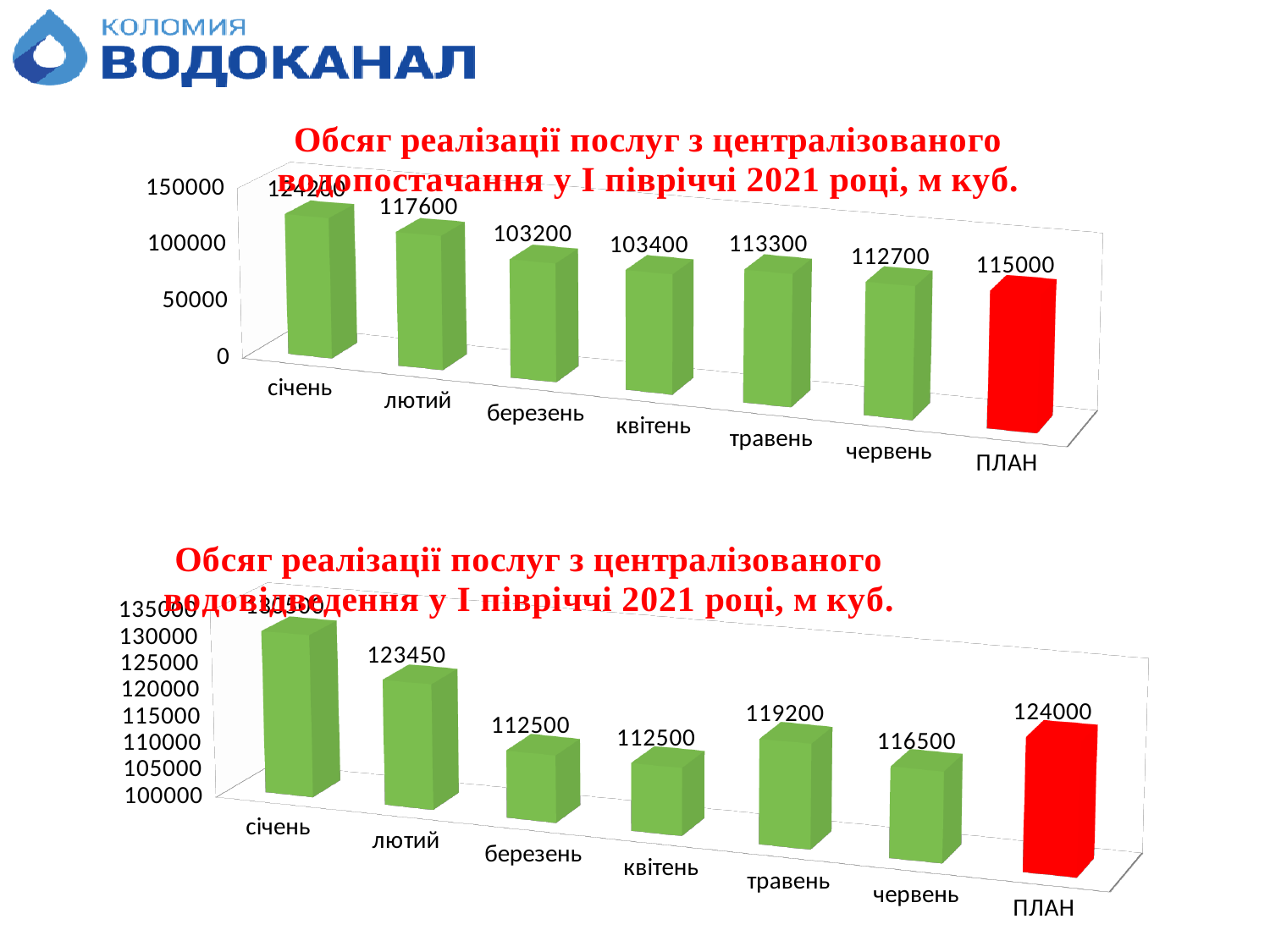
In the top chart (водопостачання), which is larger: the value for лютий or the value for ПЛАН? лютий In the bottom chart (водовідведення), what is the difference between the values for ПЛАН and лютий? 550 In the bottom chart (водовідведення), what is the value for травень? 119200 In the bottom chart (водовідведення), what colour is the ПЛАН bar? red In the bottom chart (водовідведення), which category has the highest value? січень In the top chart (водопостачання), how many categories are shown on the x axis? 7 What kind of chart is the top chart (водопостачання)? bar chart In the bottom chart (водовідведення), which is larger: the value for червень or the value for травень? травень In the top chart (водопостачання), what is the difference between the values for травень and червень? 600 In the bottom chart (водовідведення), what is the value for ПЛАН? 124000 In the top chart (водопостачання), what is the value for ПЛАН? 115000 In the top chart (водопостачання), what is the value for лютий? 117600